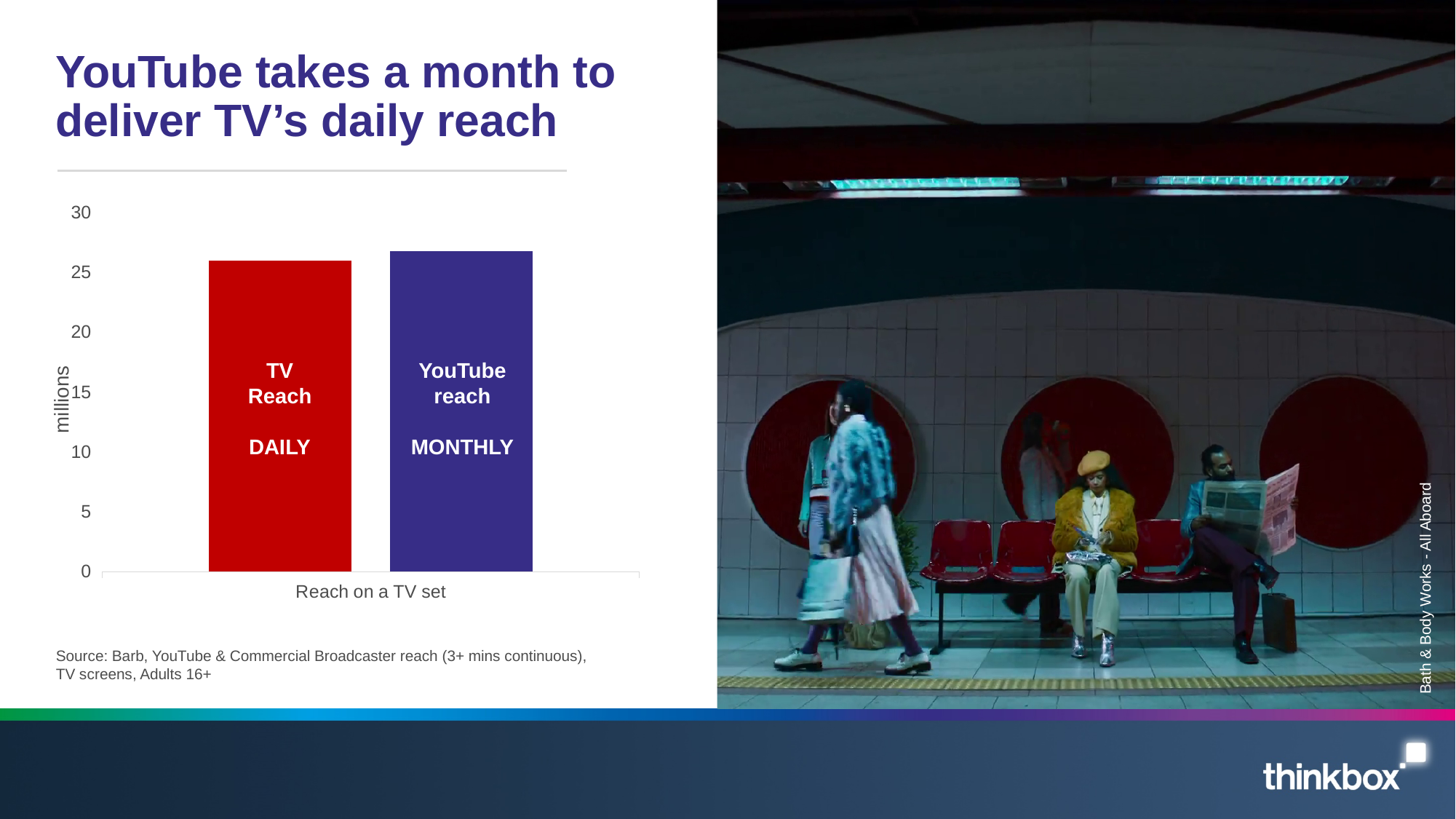
Is the value for YouTube reach MONTHLY greater or less than 20? greater Is the value for TV Reach DAILY greater or less than 25? greater What kind of chart is shown on the slide? bar chart How many bars are plotted in the chart? 2 What unit is shown on the vertical axis of the chart? millions Is the value for YouTube reach MONTHLY greater or less than 30? less What is the label under the horizontal axis of the chart? Reach on a TV set